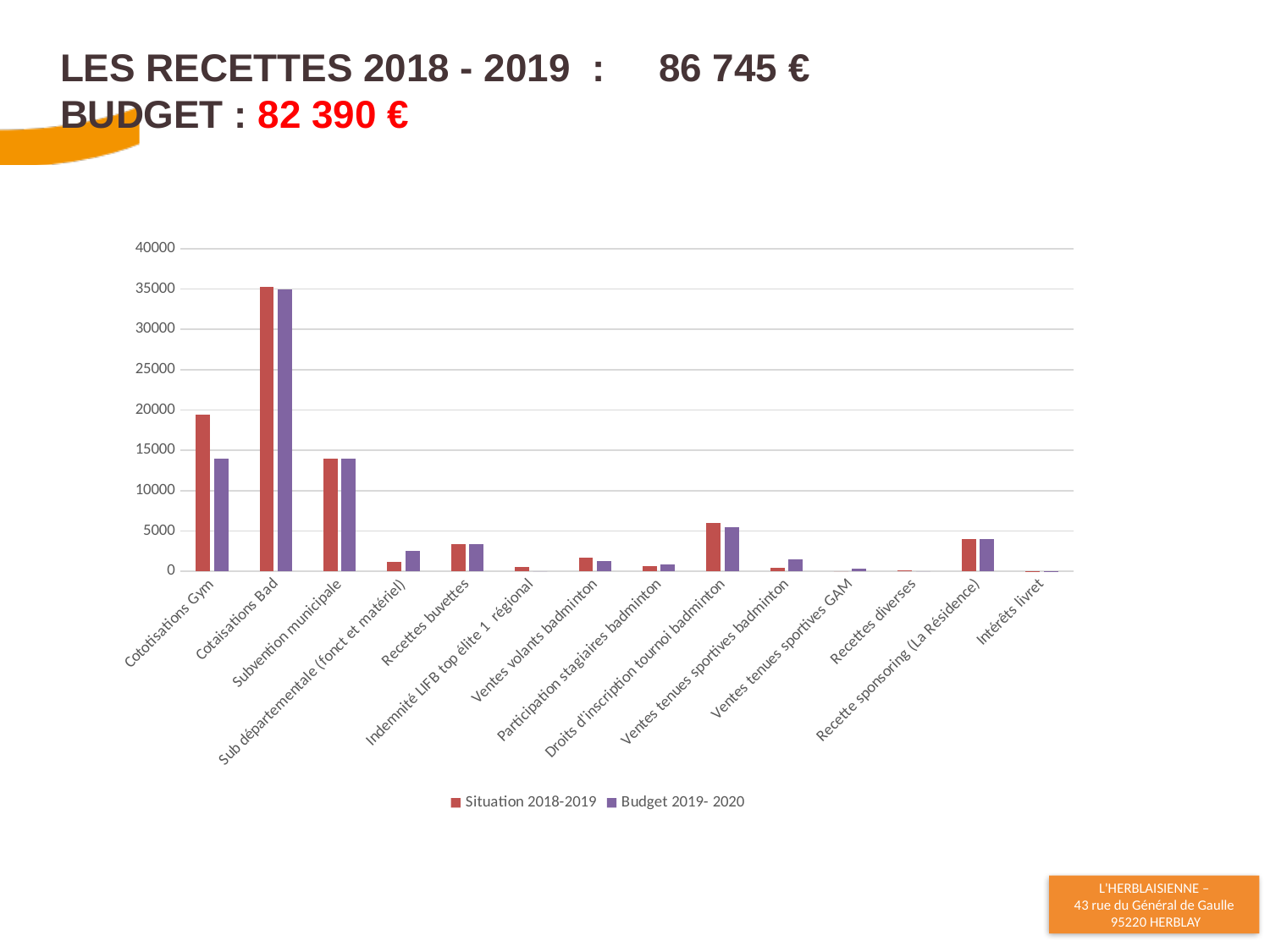
How many series does the chart legend list? 2 For Cototisations Gym, which series has the larger value: Situation 2018-2019 or Budget 2019- 2020? Situation 2018-2019 Which category has the highest value for the Budget 2019- 2020 series? Cotaisations Bad How many categories are shown along the x axis of the chart? 14 What kind of chart is shown on the slide? bar chart Is the Situation 2018-2019 value for Cototisations Gym greater or less than 15000? greater Is the Situation 2018-2019 value for Cotaisations Bad greater or less than 30000? greater Which category has the highest value for the Situation 2018-2019 series? Cotaisations Bad For Ventes tenues sportives badminton, which series has the larger value: Situation 2018-2019 or Budget 2019- 2020? Budget 2019- 2020 Is the Budget 2019- 2020 value for Subvention municipale greater or less than 15000? less What are the two series names listed in the chart legend? Situation 2018-2019 and Budget 2019- 2020